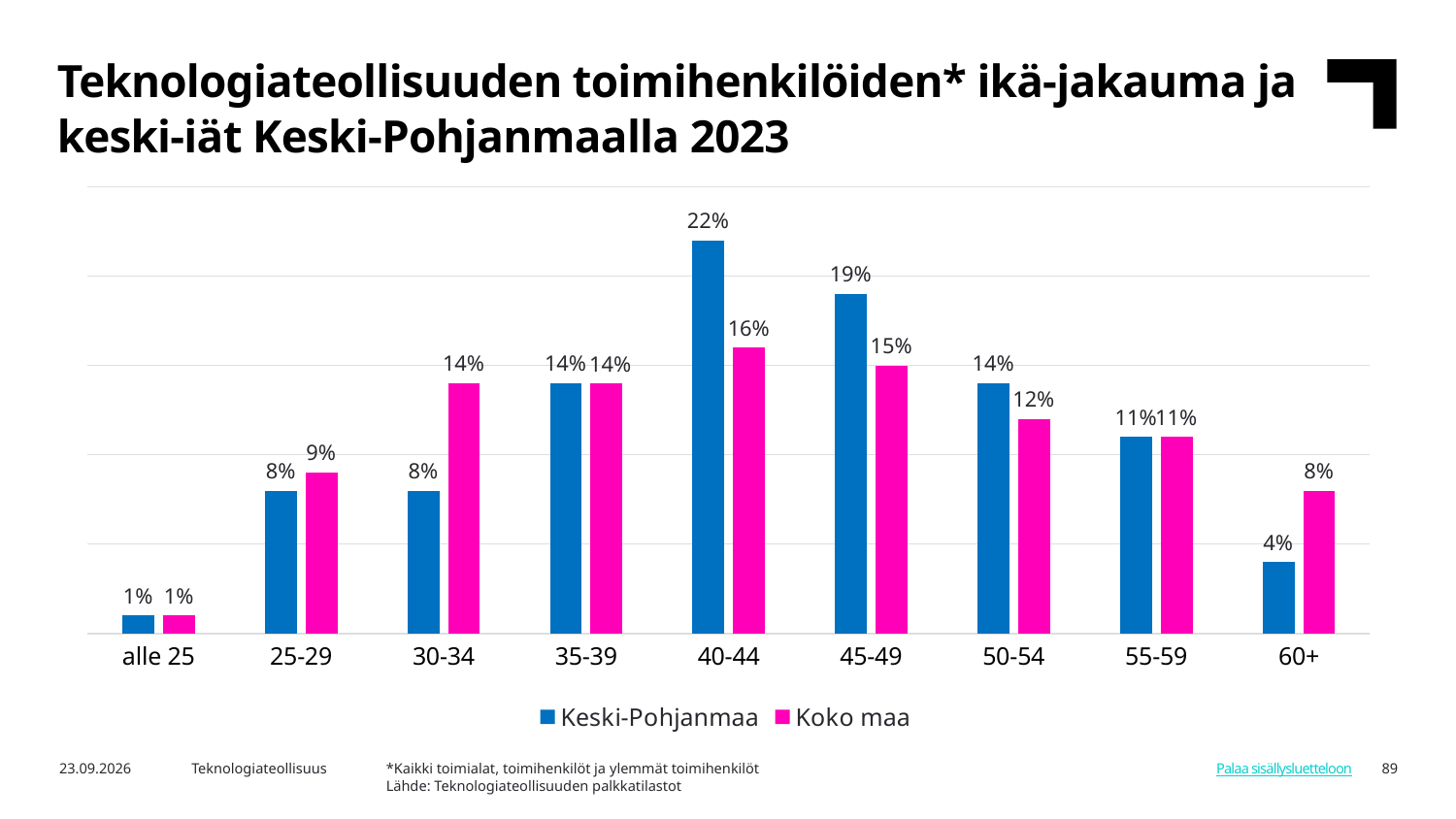
Which series is shown in pink in the legend? Koko maa How many series does the legend list? 2 What is the difference between Keski-Pohjanmaa and Koko maa in the 45-49 age group? 4 percentage points What is the value for Keski-Pohjanmaa in the 40-44 age group? 22% Which age group has the lowest value for Koko maa? alle 25 What is the value for Koko maa in the 30-34 age group? 14% What is the value for Koko maa in the 60+ age group? 8% In the 30-34 age group, which series has the larger value, Keski-Pohjanmaa or Koko maa? Koko maa How many age groups are shown on the x axis? 9 What kind of chart is shown on the slide? Bar chart Which age group has the highest value for Keski-Pohjanmaa? 40-44 In the 50-54 age group, which series has the larger value, Keski-Pohjanmaa or Koko maa? Keski-Pohjanmaa